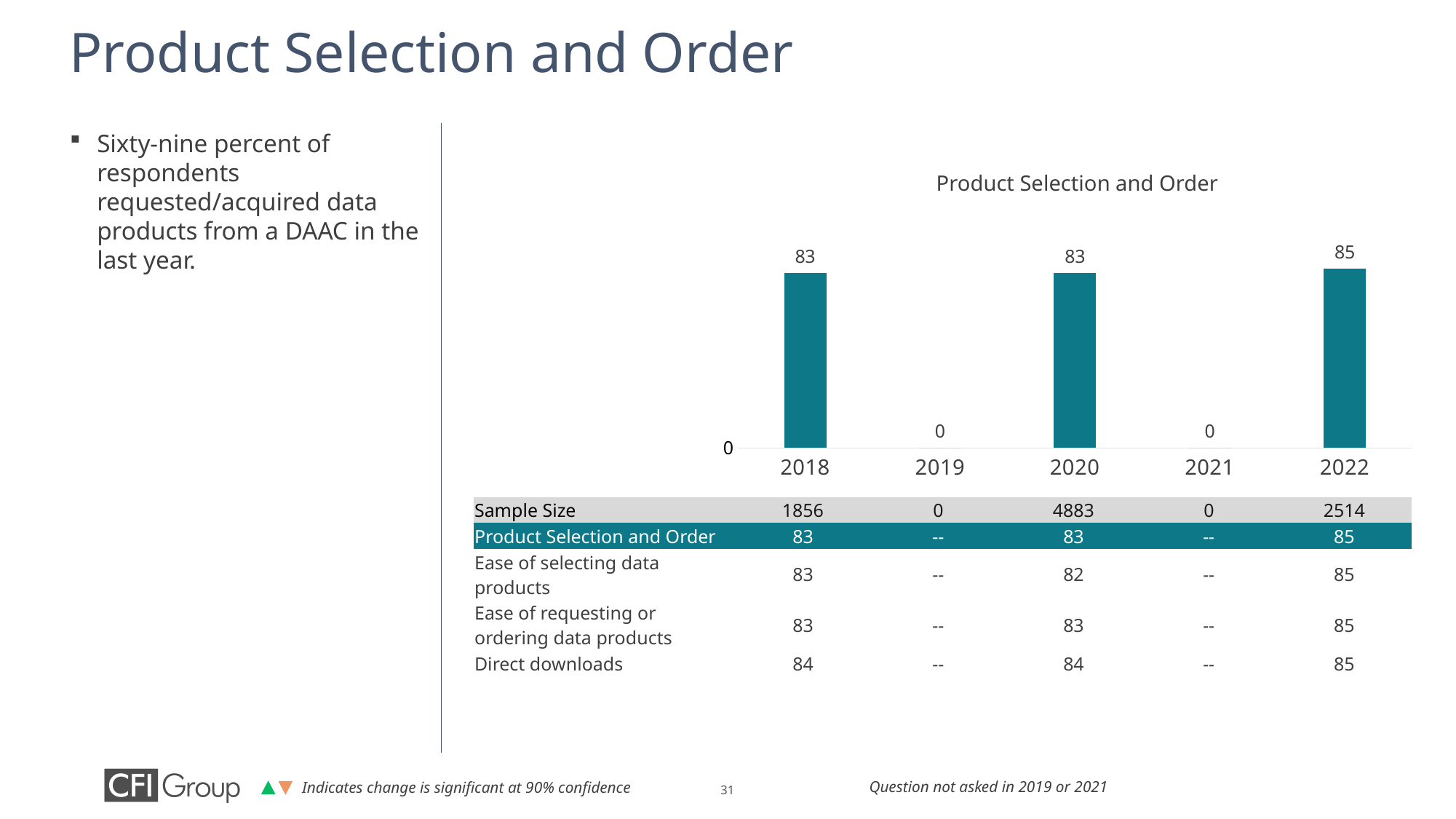
What kind of chart is the Product Selection and Order chart? bar chart What is the value for 2018 in the Product Selection and Order chart? 83 What is the value for 2020 in the Product Selection and Order chart? 83 How many years are shown on the x axis of the Product Selection and Order chart? 5 What value is shown for 2019 in the Product Selection and Order chart? 0 What colour are the bars in the Product Selection and Order chart? teal How many years in the Product Selection and Order chart have a value of 0? 2 What is the difference between the 2022 and 2018 values in the Product Selection and Order chart? 2 Is the value for 2022 larger or smaller than the value for 2020 in the Product Selection and Order chart? larger Which year has the highest value in the Product Selection and Order chart? 2022 What is the value for 2022 in the Product Selection and Order chart? 85 What is the title of the chart on the slide? Product Selection and Order